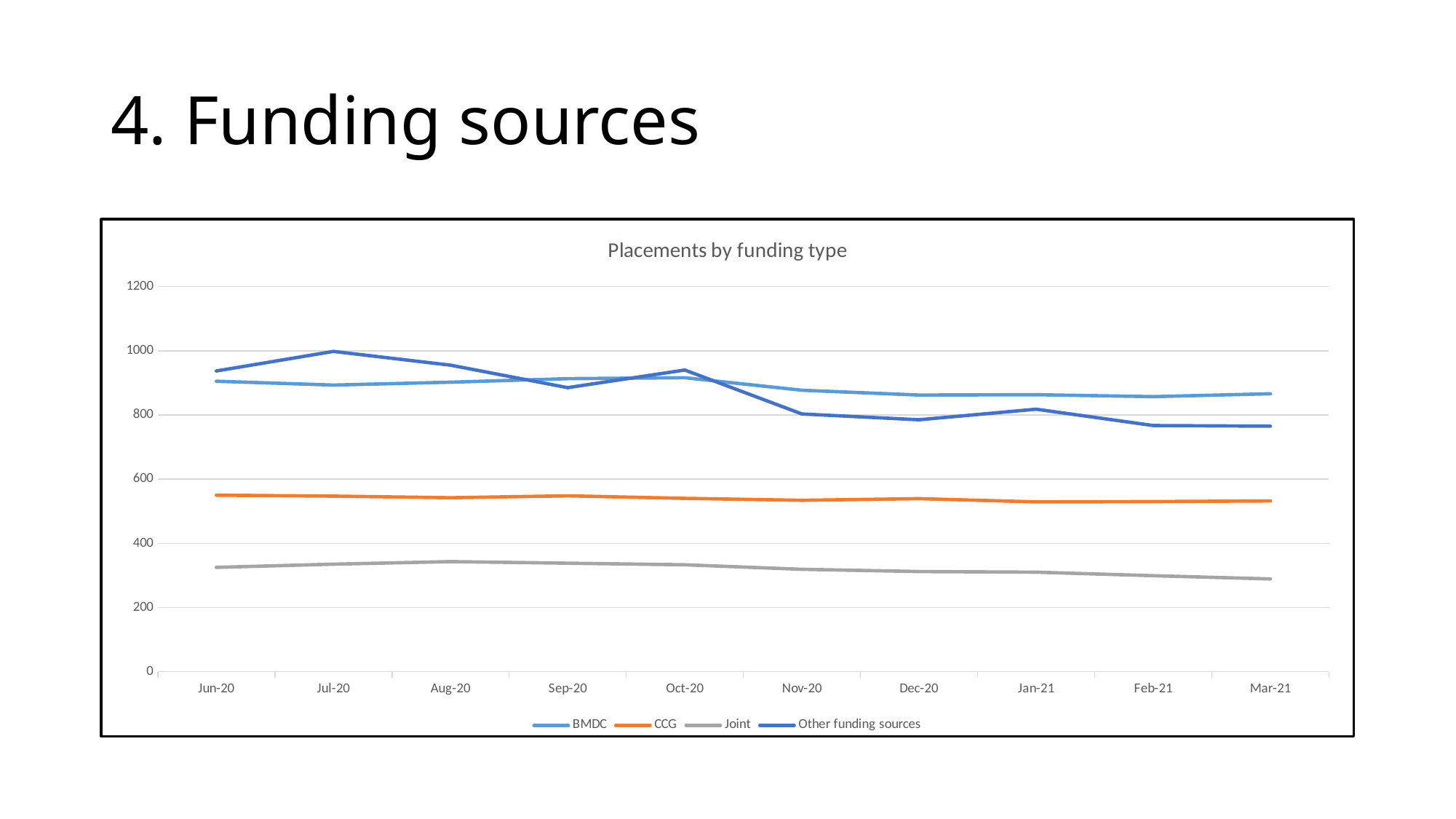
What kind of chart is shown on the slide? line chart What is the title of the chart? Placements by funding type Is the value for Other funding sources in Mar-21 greater or less than 800? less How many series does the legend list? 4 How many months are plotted along the x axis? 10 Which colour is used for the CCG line? orange In which month does Other funding sources reach its highest value? Jul-20 Is the value for Joint in Mar-21 greater or less than 400? less Which series has the lowest values across all months? Joint Is the value for Other funding sources in Jul-20 greater or less than 800? greater In Dec-20, which is larger: BMDC or Other funding sources? BMDC